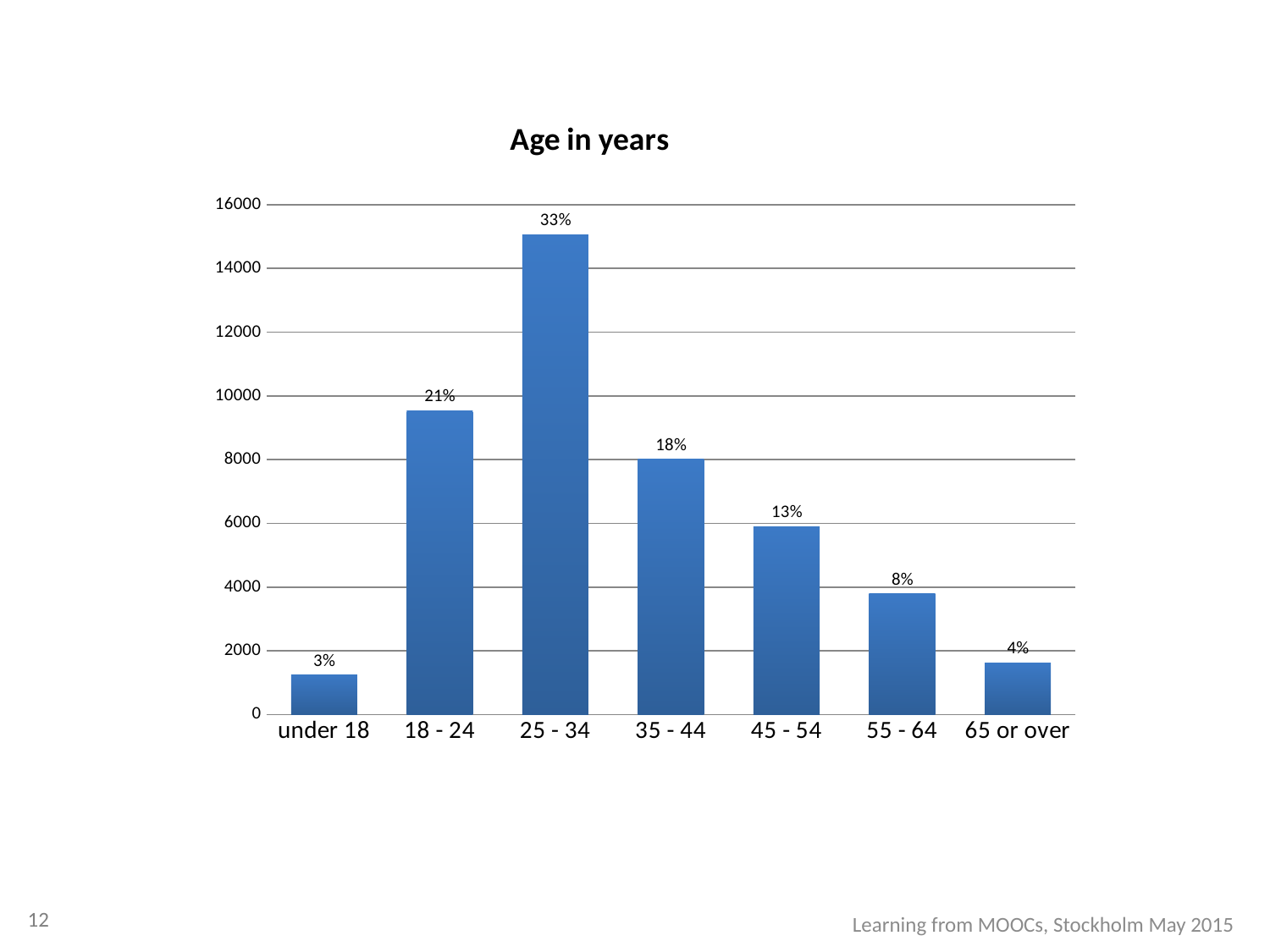
What is the difference in percentage points between the labels for 18 - 24 and 35 - 44? 3% Which age category has the lowest bar? under 18 What is the title of the chart? Age in years Which age category has the highest bar? 25 - 34 Is the value for 55 - 64 greater or less than 4000? less How many age categories are shown on the x axis? 7 What kind of chart is shown on the slide? bar chart Is the value for 25 - 34 greater or less than 14000? greater What percentage label is shown on the bar for 25 - 34? 33% What percentage label is shown on the bar for 55 - 64? 8% What percentage label is shown on the bar for under 18? 3% Which bar is taller, 45 - 54 or 65 or over? 45 - 54